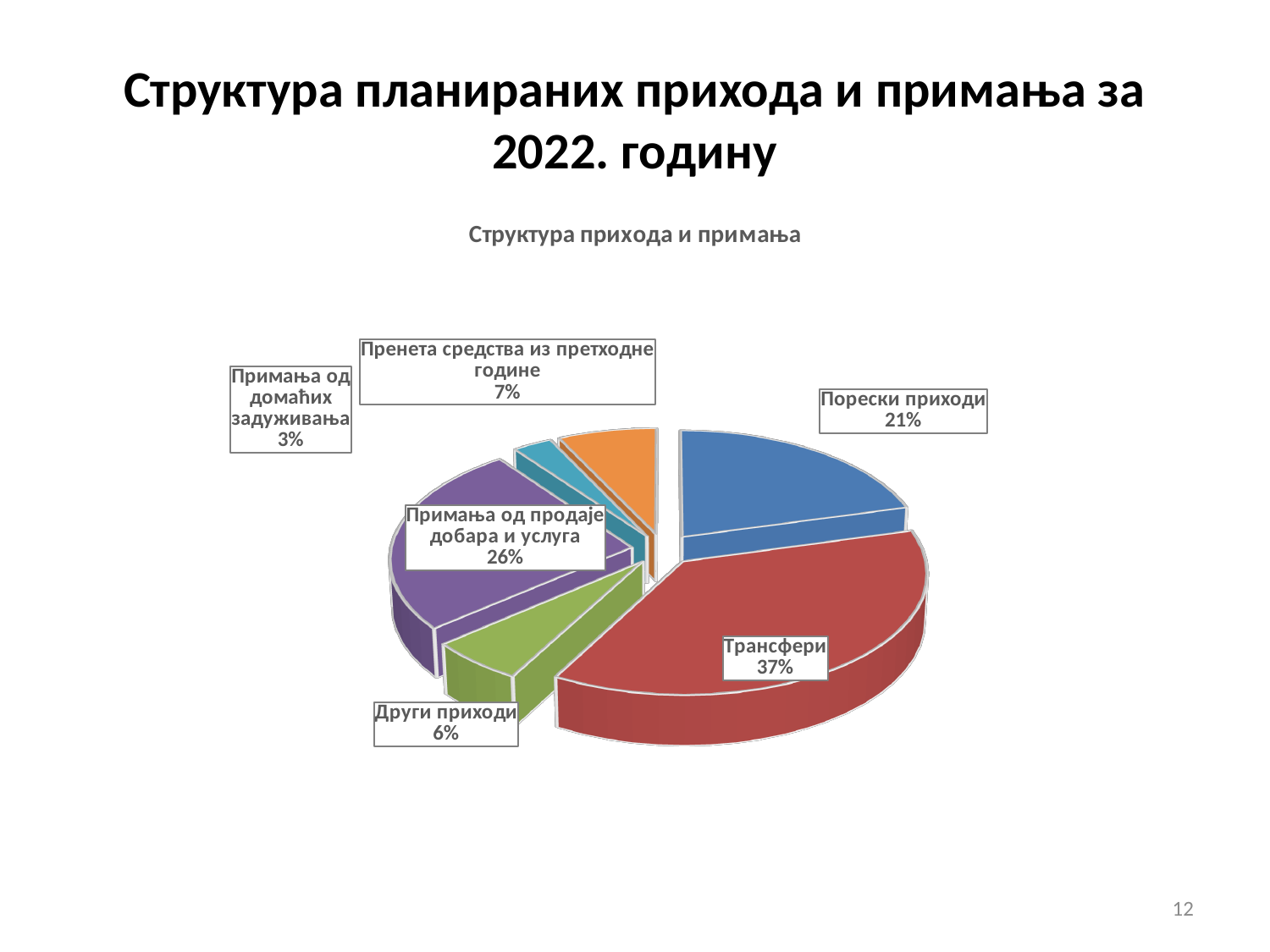
What share of the pie does Трансфери have? 37% What is the difference in percentage points between Трансфери and Порески приходи? 16 Which category has the largest share of the pie? Трансфери What kind of chart is shown on the slide? Pie chart What share of the pie does Пренета средства из претходне године have? 7% What share of the pie does Примања од продаје добара и услуга have? 26% Which category has the smallest share of the pie? Примања од домаћих задуживања Which is larger, Примања од продаје добара и услуга or Порески приходи? Примања од продаје добара и услуга How many categories are shown in the pie chart? 6